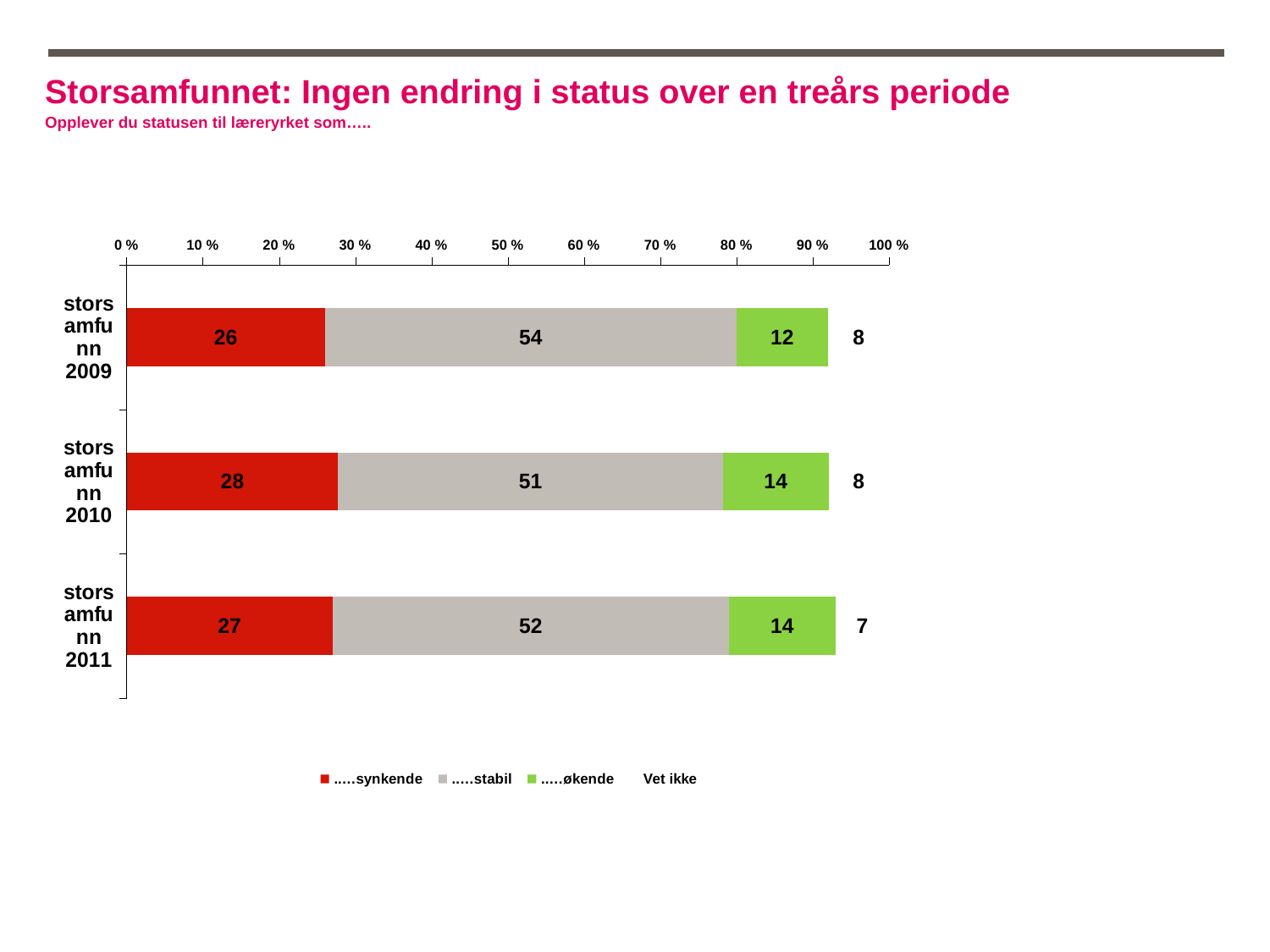
What is the value for '.....synkende' for storsamfunn 2010? 28 How many series does the legend list? 4 What is the value for '.....stabil' for storsamfunn 2009? 54 Which category has the lowest '.....økende' value? storsamfunn 2009 What is the value for '.....økende' for storsamfunn 2011? 14 What is the difference between the '.....stabil' values for storsamfunn 2009 and storsamfunn 2010? 3 What kind of chart is shown on the slide? Stacked bar chart Which category has the highest '.....stabil' value? storsamfunn 2009 What is the total of the stacked bar for storsamfunn 2011? 100 Is the '.....synkende' value for storsamfunn 2010 larger than that for storsamfunn 2009? Yes What is the 'Vet ikke' value for storsamfunn 2011? 7 How many categories are plotted on the chart? 3